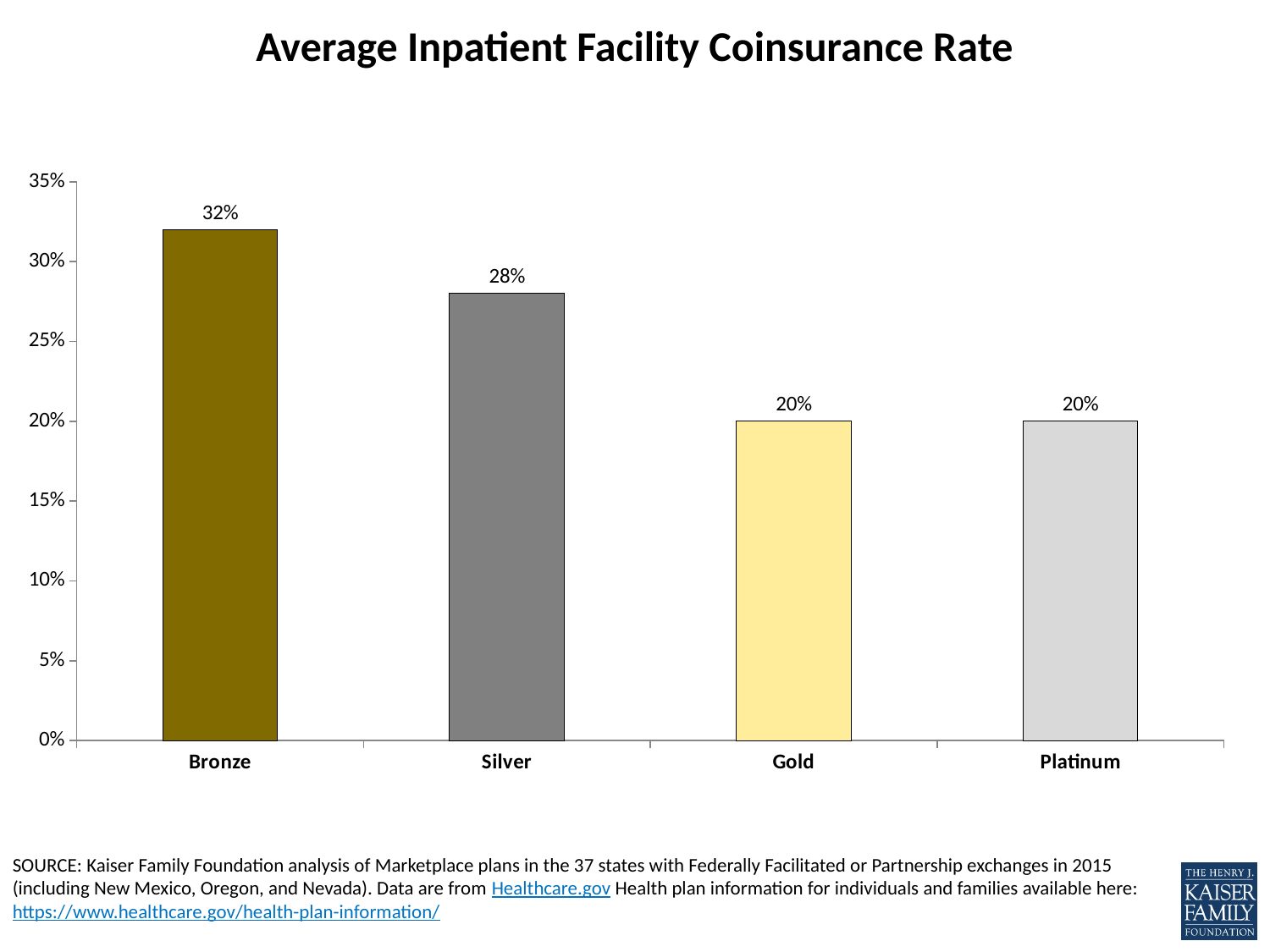
What is the difference between the Silver and Gold average inpatient facility coinsurance rates? 8% How many plan tiers are shown on the chart? 4 Which has a higher average inpatient facility coinsurance rate, Bronze or Silver? Bronze What kind of chart is shown on the slide? Bar chart What is the title of the chart? Average Inpatient Facility Coinsurance Rate What is the average inpatient facility coinsurance rate for Platinum plans? 20% What is the difference between the Bronze and Silver average inpatient facility coinsurance rates? 4% Which plan tier has the highest average inpatient facility coinsurance rate? Bronze What is the average inpatient facility coinsurance rate for Silver plans? 28% What is the average inpatient facility coinsurance rate for Bronze plans? 32% What is the average inpatient facility coinsurance rate for Gold plans? 20% Is the value for Silver greater or less than 25%? greater